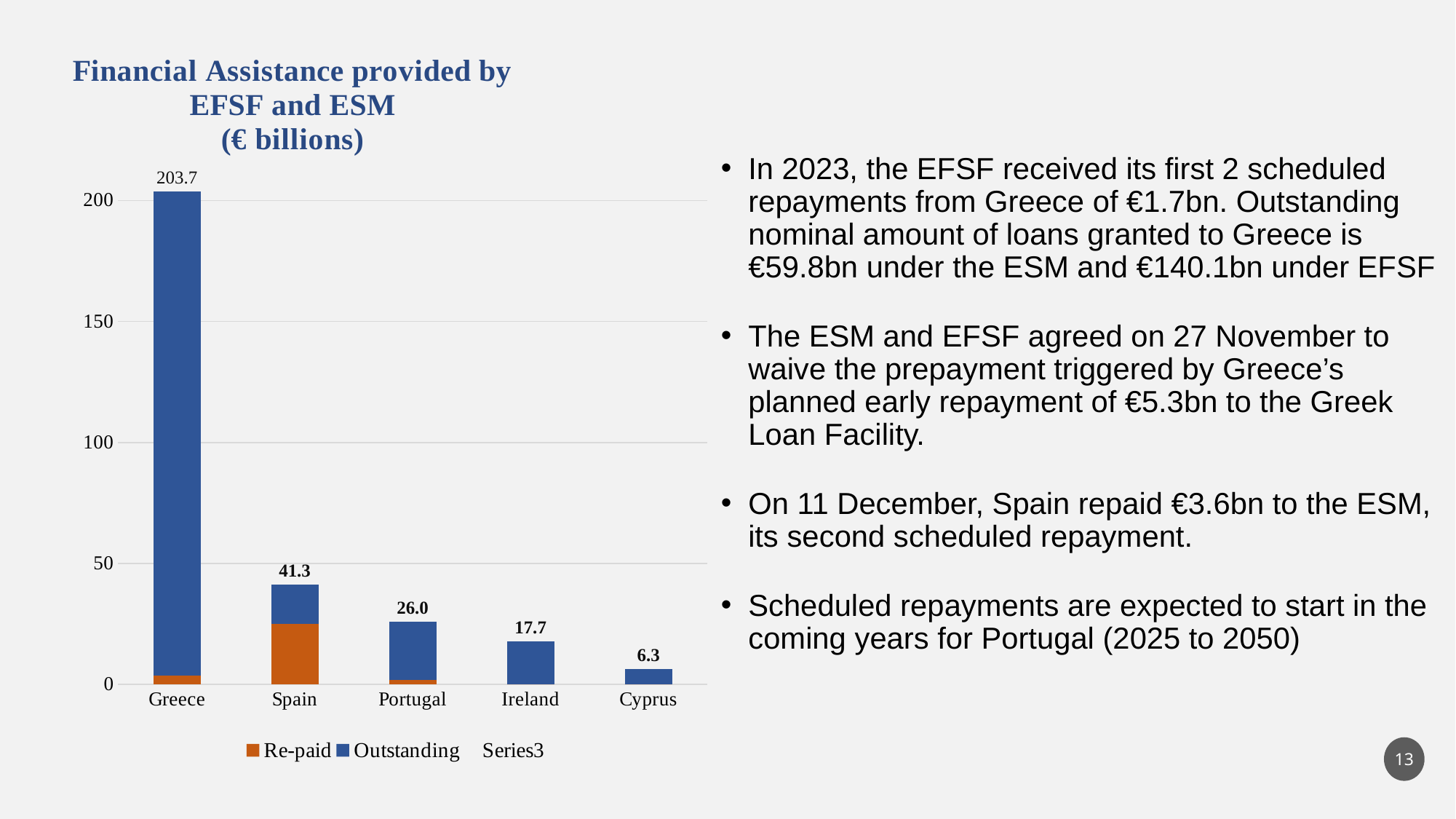
Which country has the lowest total bar? Cyprus What is the total financial assistance shown for Greece? 203.7 What is the total value labelled for Cyprus? 6.3 What is the difference between the total for Portugal and the total for Ireland? 8.3 Which country has the highest total bar? Greece Do the total values rise or fall from Greece to Cyprus along the x axis? fall What is the total value labelled for Spain? 41.3 How many series does the legend list? 3 Which has a larger total, Portugal or Ireland? Portugal Is the Re-paid portion of the Spain bar greater or less than 50? less What is the difference between the total for Greece and the total for Spain? 162.4 How many countries are shown on the x axis? 5